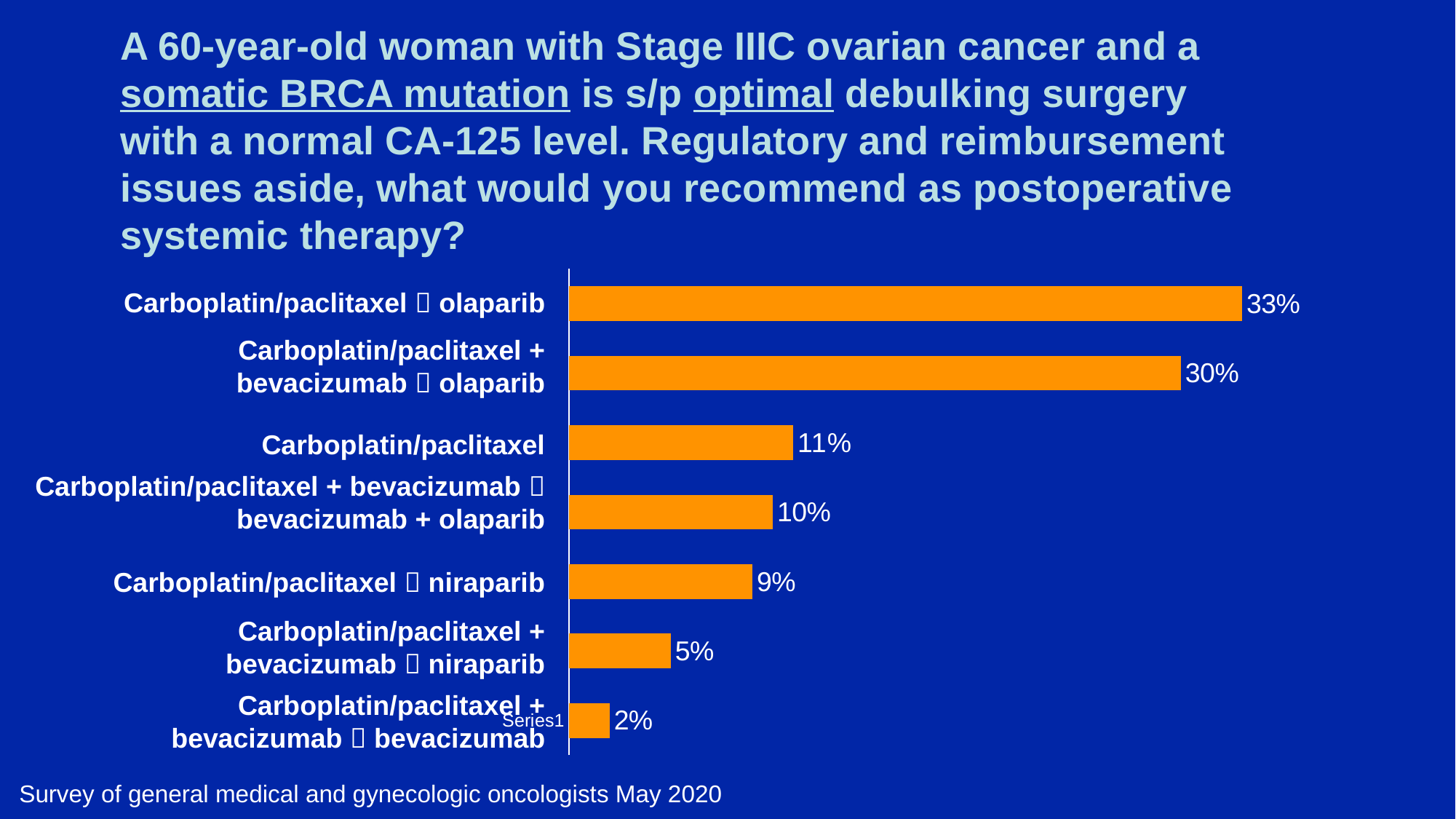
What percentage of respondents recommended Carboplatin/paclitaxel followed by niraparib? 9% Which option received the highest percentage of recommendations? Carboplatin/paclitaxel followed by olaparib What percentage of respondents recommended Carboplatin/paclitaxel alone? 11% What type of chart is shown on the slide? Bar chart What is the difference in percentage points between Carboplatin/paclitaxel + bevacizumab followed by niraparib and Carboplatin/paclitaxel + bevacizumab followed by bevacizumab? 3 percentage points What percentage of respondents recommended Carboplatin/paclitaxel followed by olaparib? 33% What colour are the bars in the chart? Orange What percentage of respondents recommended Carboplatin/paclitaxel + bevacizumab followed by olaparib? 30% How many treatment options are shown in the chart? 7 What is the difference in percentage points between Carboplatin/paclitaxel followed by olaparib and Carboplatin/paclitaxel + bevacizumab followed by olaparib? 3 percentage points Which option received the lowest percentage of recommendations? Carboplatin/paclitaxel + bevacizumab followed by bevacizumab Which received a higher percentage: Carboplatin/paclitaxel followed by niraparib or Carboplatin/paclitaxel + bevacizumab followed by niraparib? Carboplatin/paclitaxel followed by niraparib